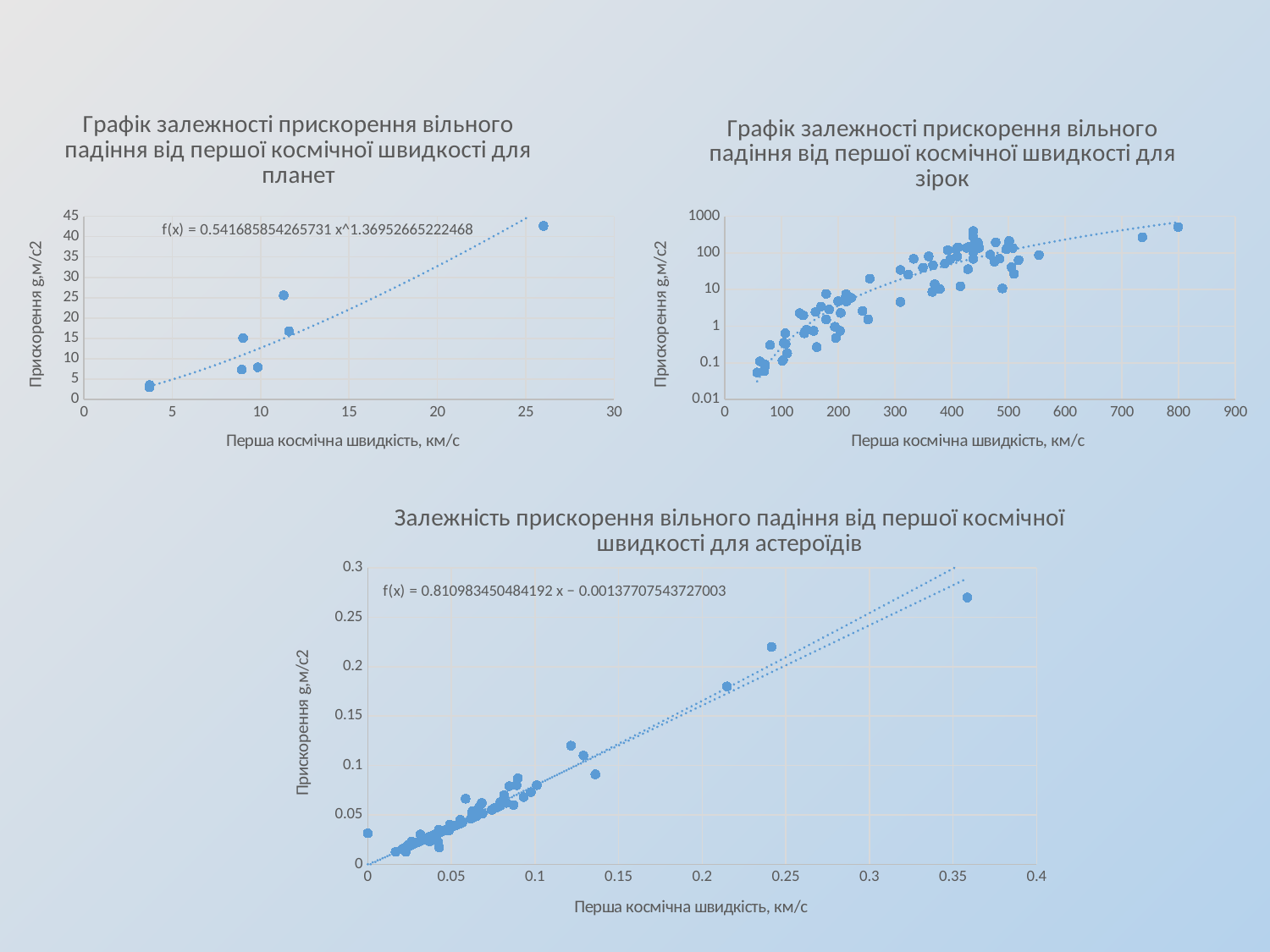
In the chart for asteroids (bottom), is the value for the rightmost point (near 0.36 km/s) greater or less than 0.25? greater In the chart for stars (top right), what is the label of the x axis? Перша космічна швидкість, км/с In the chart for planets (top left), what trendline equation is printed on the chart? f(x) = 0.541685854265731 x^1.36952665222468 In the chart for stars (top right), do the values generally rise or fall along the x axis? rise In the chart for planets (top left), do the values of acceleration generally rise or fall as the first cosmic velocity increases? rise In the chart for asteroids (bottom), is the value for the point near 0.24 km/s greater or less than 0.2? greater What kind of chart is the chart titled 'Графік залежності прискорення вільного падіння від першої космічної швидкості для планет'? scatter chart In the chart for asteroids (bottom), do the values rise or fall as the first cosmic velocity increases? rise In the chart for stars (top right), is the value for the rightmost point (near 800 km/s) greater or less than 100? greater What kind of chart is the chart for asteroids (bottom)? scatter chart